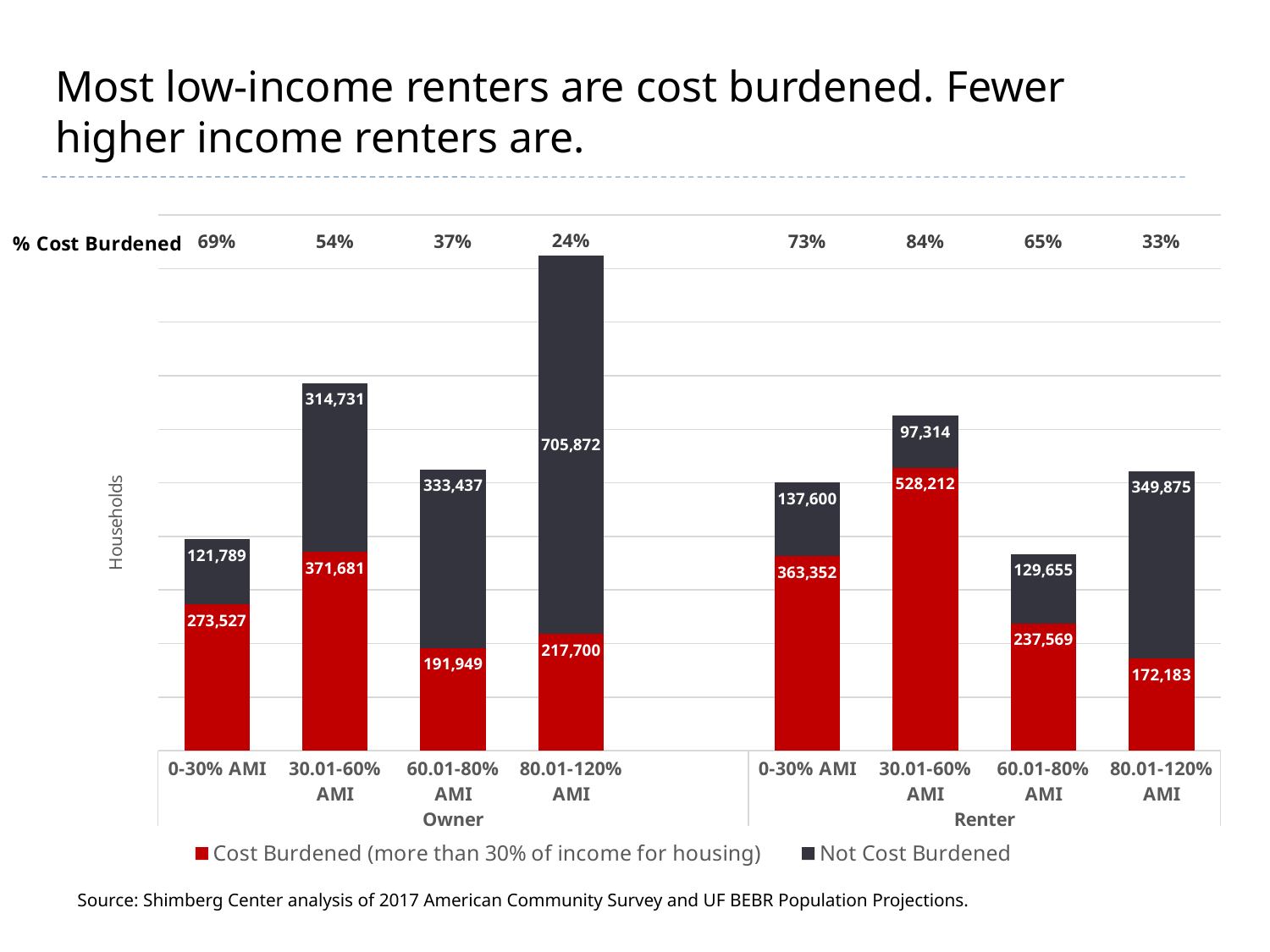
How many income categories (bars) are shown in the chart? 8 Which is larger: the Cost Burdened value for Owners at 60.01-80% AMI or for Renters at 60.01-80% AMI? Renters at 60.01-80% AMI What is the Not Cost Burdened value for Renter households at 80.01-120% AMI? 349,875 How many Owner households in the 0-30% AMI group are Cost Burdened? 273,527 Which category has the largest Not Cost Burdened value? Owner 80.01-120% AMI How many series does the legend list? 2 What percentage of Renter households at 30.01-60% AMI are cost burdened, according to the % Cost Burdened row? 84% What type of chart is shown on the slide? Stacked bar chart What is the total number of households in the Renter 30.01-60% AMI bar? 625,526 What is the difference between the Cost Burdened value for Renters at 30.01-60% AMI and Owners at 30.01-60% AMI? 156,531 Which category has the smallest Not Cost Burdened value? Renter 30.01-60% AMI Which category has the largest Cost Burdened value? Renter 30.01-60% AMI